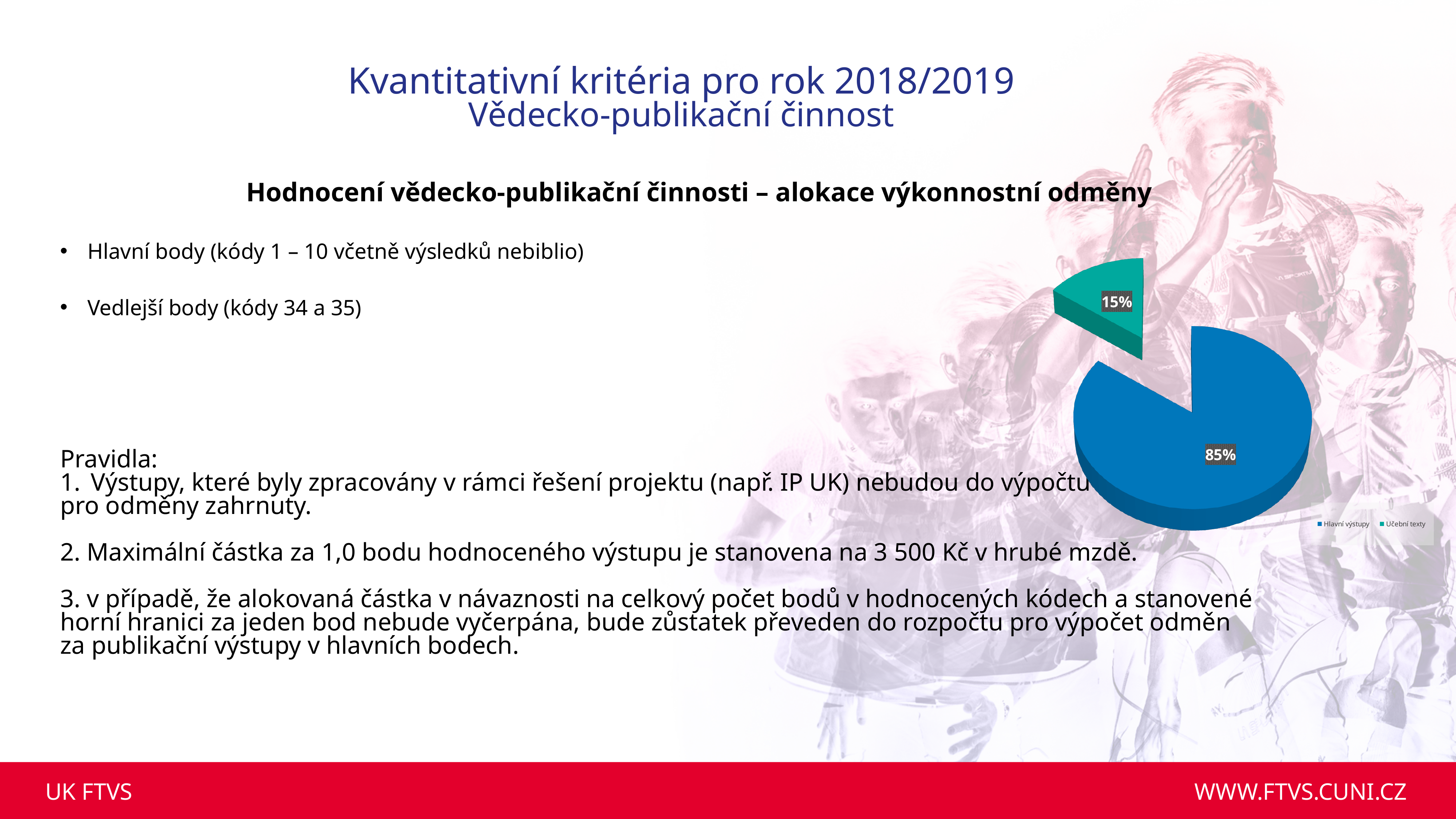
What colour is the Učební texty slice in the pie chart? teal What is the difference in percentage points between the Hlavní výstupy slice and the Učební texty slice? 70 What share of the pie does Učební texty take? 15% What kind of chart is shown on the slide? pie chart Which slice of the pie chart is the largest? Hlavní výstupy What colour is the Hlavní výstupy slice in the pie chart? blue Which is larger, the Hlavní výstupy slice or the Učební texty slice? Hlavní výstupy What share of the pie does Hlavní výstupy take? 85% Which slice of the pie chart is the smallest? Učební texty How many slices does the pie chart have? 2 How many entries does the chart legend list? 2